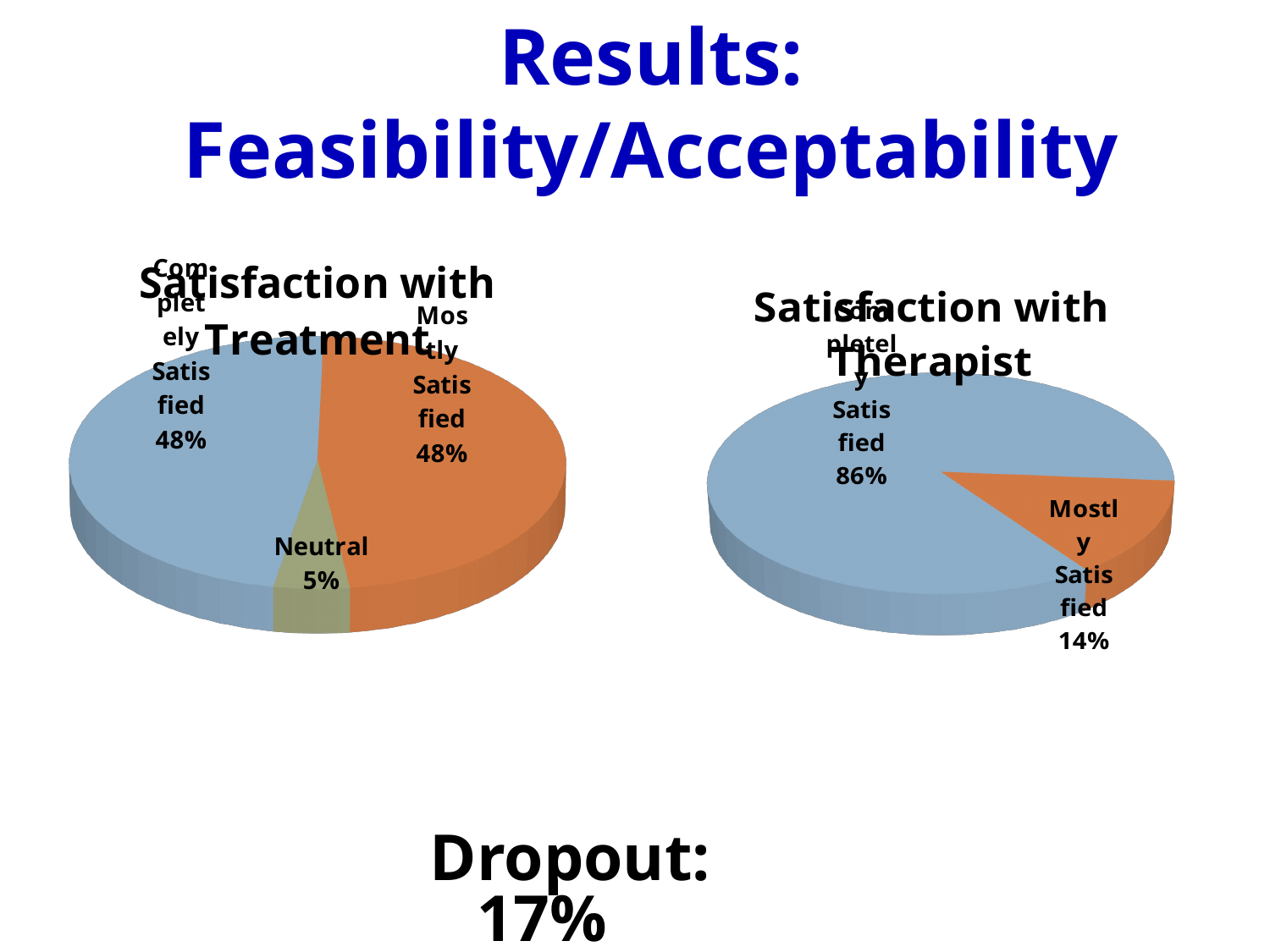
In the 'Satisfaction with Treatment' chart, how many slices does the pie have? 3 What type of chart is the 'Satisfaction with Treatment' chart? Pie chart In the 'Satisfaction with Therapist' chart, what share is Completely Satisfied? 86% In the 'Satisfaction with Therapist' chart, what is the difference between the Completely Satisfied and Mostly Satisfied shares? 72% In the 'Satisfaction with Therapist' chart, how many slices does the pie have? 2 In the 'Satisfaction with Therapist' chart, which category has the largest slice? Completely Satisfied In the 'Satisfaction with Treatment' chart, what share is Mostly Satisfied? 48% In the 'Satisfaction with Treatment' chart, what colour is the Neutral slice? Green In the 'Satisfaction with Treatment' chart, what share is labelled Neutral? 5% In the 'Satisfaction with Treatment' chart, which category has the smallest slice? Neutral In the 'Satisfaction with Therapist' chart, what share is Mostly Satisfied? 14% In the 'Satisfaction with Treatment' chart, what share is Completely Satisfied? 48%